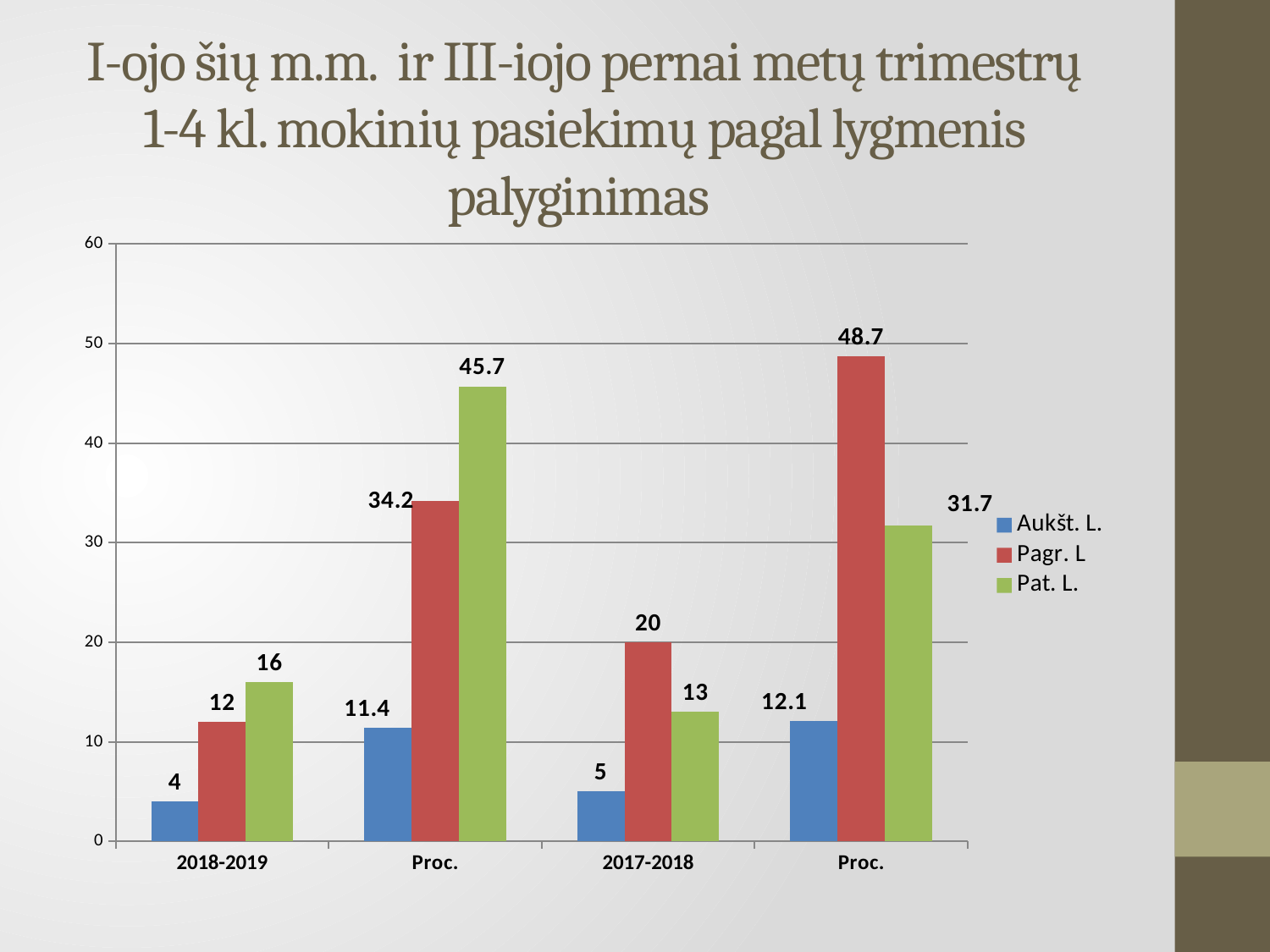
Which is larger: the Pagr. L value in the second Proc. category (following 2017-2018) or the Pat. L. value in the first Proc. category (following 2018-2019)? Pagr. L in the second Proc. category (48.7) Which series has the lowest value in the first Proc. category (following 2018-2019)? Aukšt. L. What is the value for Pat. L. in the second Proc. category (the one following 2017-2018)? 31.7 What is the difference between the Pat. L. and Pagr. L values in the 2018-2019 category? 4 How many series does the legend list? 3 What is the value for Pagr. L in the first Proc. category (the one following 2018-2019)? 34.2 Which series has the highest value in the 2017-2018 category? Pagr. L How many categories are shown on the x axis? 4 Is the value for Pat. L. in the first Proc. category (following 2018-2019) greater or less than 40? greater What is the value for Aukšt. L. in the 2018-2019 category? 4 What kind of chart is shown on the slide? bar chart What is the value for Pat. L. in the 2017-2018 category? 13